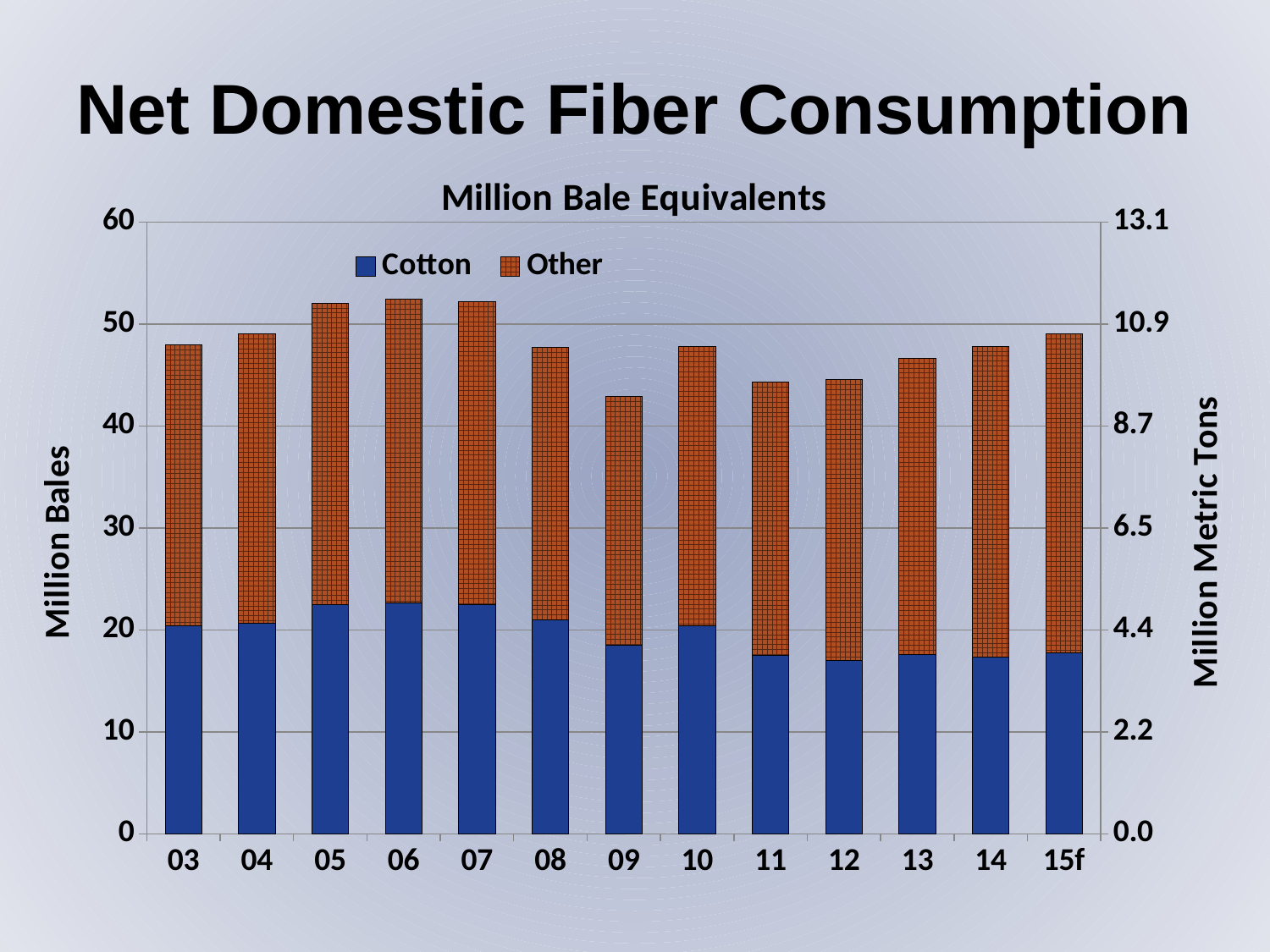
How many series does the legend list? 2 Is the total bar for 09 greater or less than 50 million bales? less Which year has the lowest total fiber consumption? 09 Is the total bar for 06 greater or less than 50 million bales? greater Is the Cotton value for 09 greater or less than 20 million bales? less Do the total bars rise or fall from 06 to 09? fall Which year has the larger Cotton value, 05 or 12? 05 What is the label on the right-hand vertical axis? Million Metric Tons What kind of chart is shown on the slide? Stacked bar chart Which year has the larger total bar, 06 or 09? 06 How many years (categories) are shown on the x axis? 13